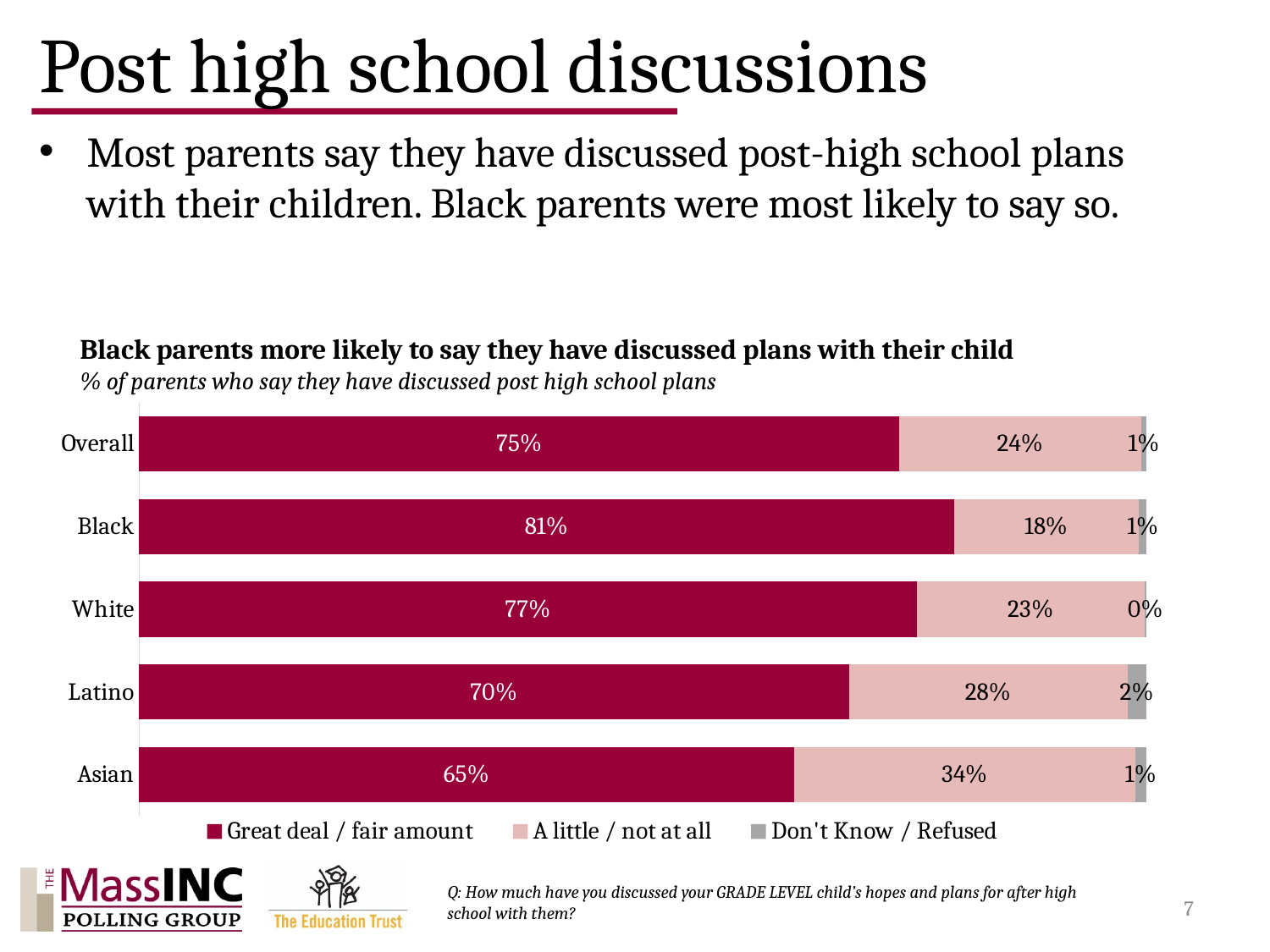
Which group has the lowest 'Great deal / fair amount' value? Asian How many groups are shown on the chart? 5 Which group has the highest 'Great deal / fair amount' value? Black What is the 'A little / not at all' value for Asian parents? 34% What percentage of Black parents say they have discussed post high school plans a great deal / fair amount? 81% What kind of chart is shown on the slide? Stacked bar chart Which is larger, the 'A little / not at all' value for Latino parents or for White parents? Latino How many series does the legend list? 3 What is the 'Don't Know / Refused' value for Latino parents? 2% What is the total of the Overall bar? 100% What is the subtitle of the chart? % of parents who say they have discussed post high school plans What is the difference between the 'Great deal / fair amount' values for Black and Asian parents? 16 percentage points